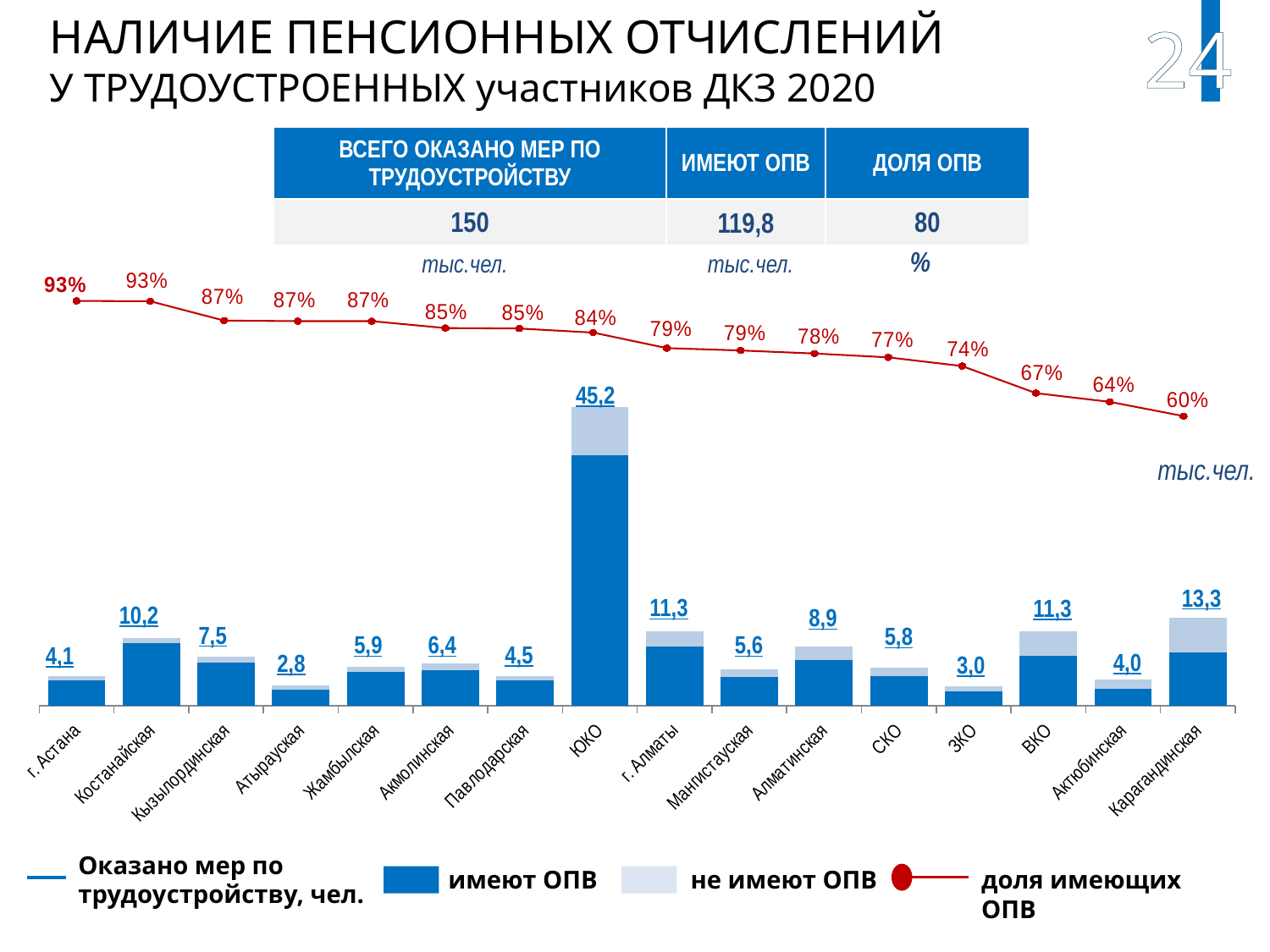
What kind of chart is shown on the slide? Combined stacked bar and line chart How many regions are shown on the x axis of the chart? 16 Which has a larger bar total, Костанайская or Кызылординская? Костанайская How many entries does the legend at the bottom of the slide list? 4 Which region has the lowest bar total? Атырауская What is the total value (тыс.чел.) shown above the bar for ЮКО? 45,2 What percentage does the line (доля имеющих ОПВ) show for г. Астана? 93% Does the line for доля имеющих ОПВ rise or fall from left to right across the regions? Fall What is the total value shown above the bar for Карагандинская? 13,3 What percentage does the line (доля имеющих ОПВ) show for Карагандинская? 60% What is the difference between the bar totals for Карагандинская and ВКО? 2,0 Which region has the highest bar total? ЮКО